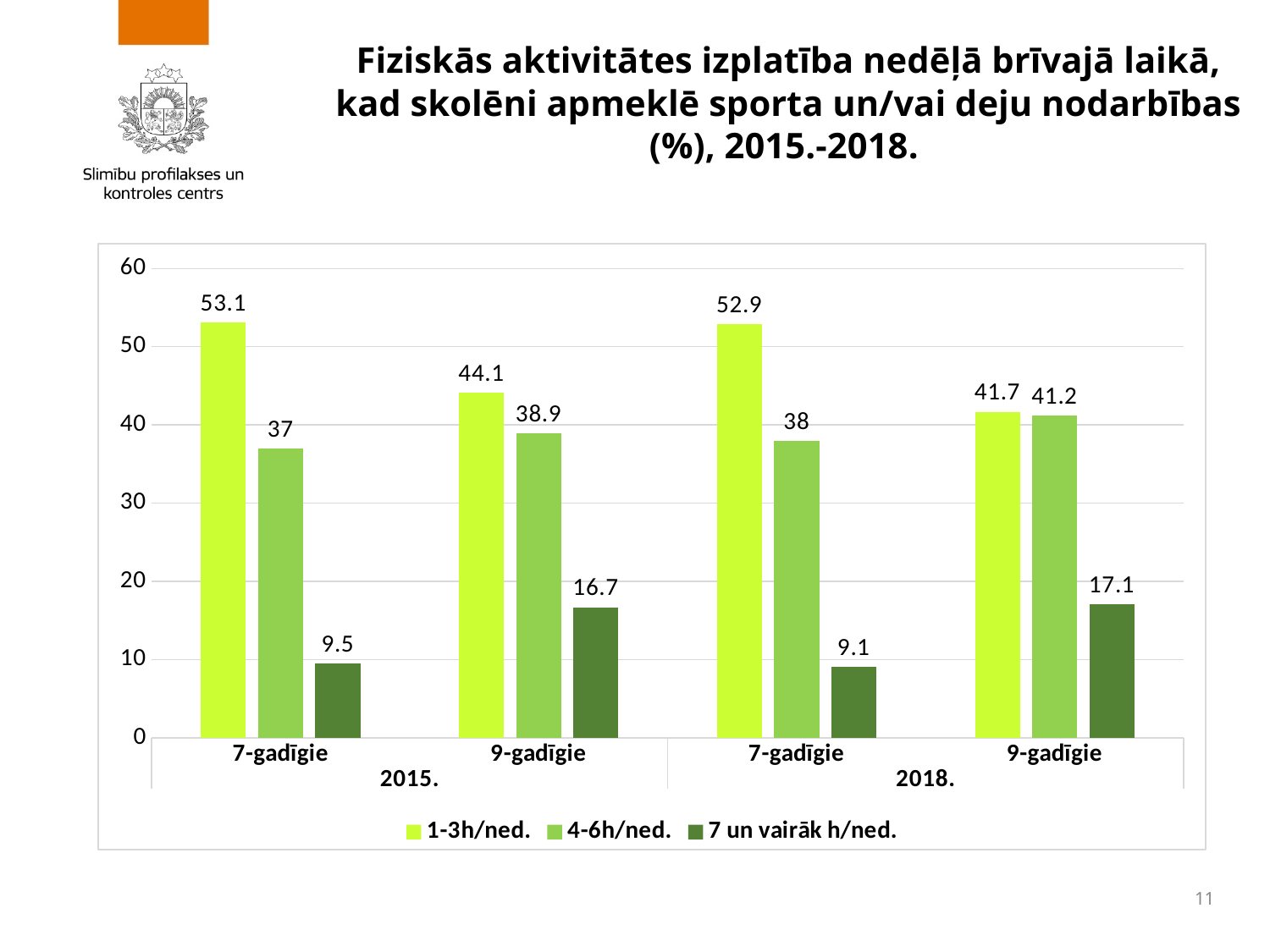
How many age-group categories are shown on the x axis in total? 4 Is the value for 7 un vairāk h/ned. among 9-gadīgie in 2015 greater or less than 20? less Which group and year has the highest value for the 1-3h/ned. series? 7-gadīgie, 2015 Which group and year has the lowest value for the 7 un vairāk h/ned. series? 7-gadīgie, 2018 What is the value for 1-3h/ned. among 7-gadīgie in 2015? 53.1 What is the value for 7 un vairāk h/ned. among 9-gadīgie in 2018? 17.1 What kind of chart is shown on the slide? bar chart What is the value for 4-6h/ned. among 7-gadīgie in 2018? 38 What is the difference between the 1-3h/ned. and 4-6h/ned. values for 7-gadīgie in 2015? 16.1 How many series does the legend list? 3 Which years are compared in the chart? 2015 and 2018 Which is larger for 9-gadīgie in 2018: the 1-3h/ned. value or the 4-6h/ned. value? 1-3h/ned.